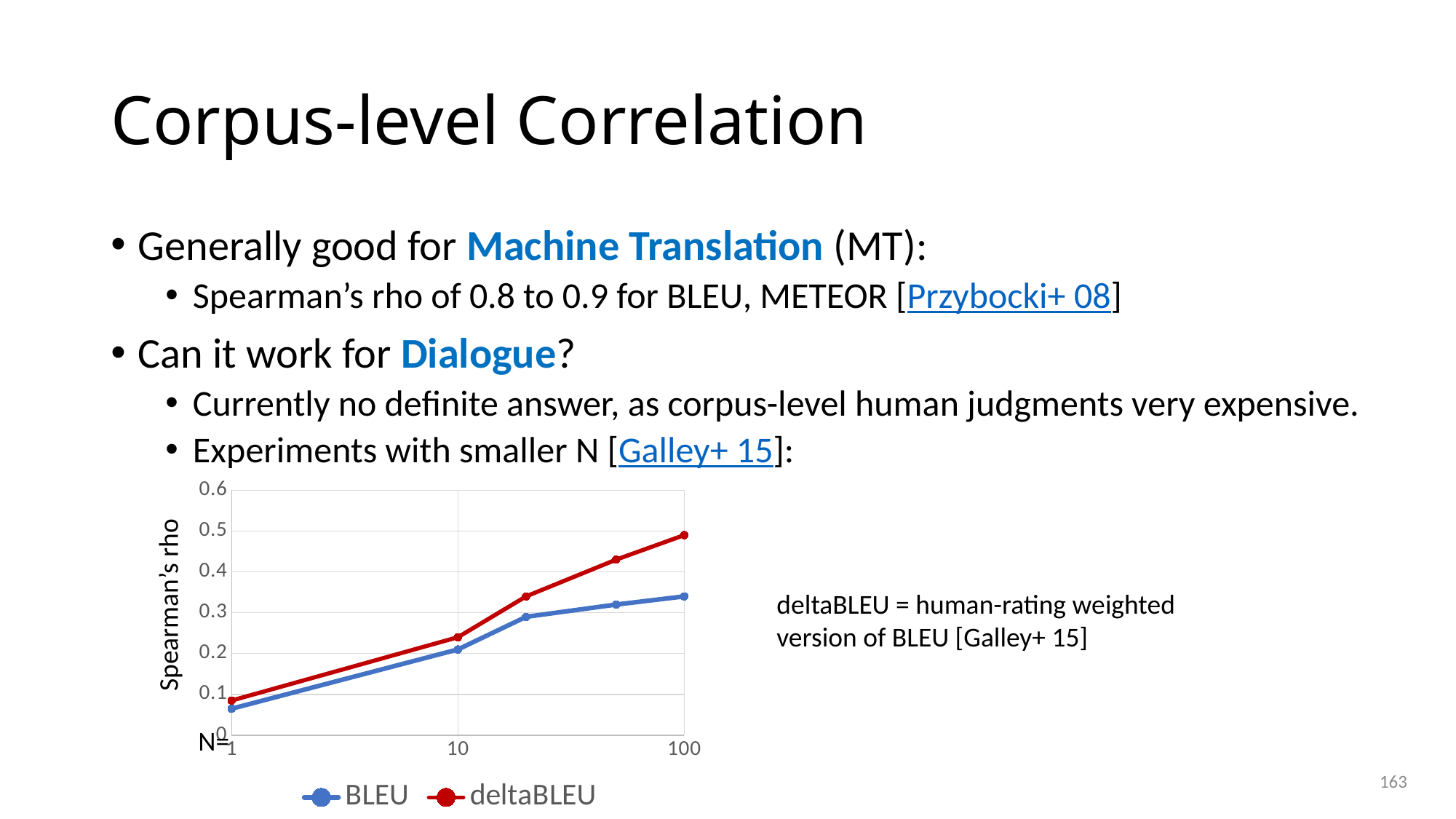
Is the Spearman's rho for BLEU at N=1 greater or less than 0.1? less What kind of chart is shown on the slide? line chart How many series does the chart's legend list? 2 At N=100, which series has the higher Spearman's rho, BLEU or deltaBLEU? deltaBLEU How many data points are plotted for the deltaBLEU series? 5 Does the Spearman's rho for deltaBLEU rise or fall as N increases? rise What is the label of the chart's y axis? Spearman's rho Is the Spearman's rho for deltaBLEU at N=100 greater or less than 0.4? greater Is the Spearman's rho for deltaBLEU at N=10 greater or less than 0.3? less Does the Spearman's rho for BLEU rise or fall as N increases? rise Which two series are listed in the chart's legend? BLEU and deltaBLEU